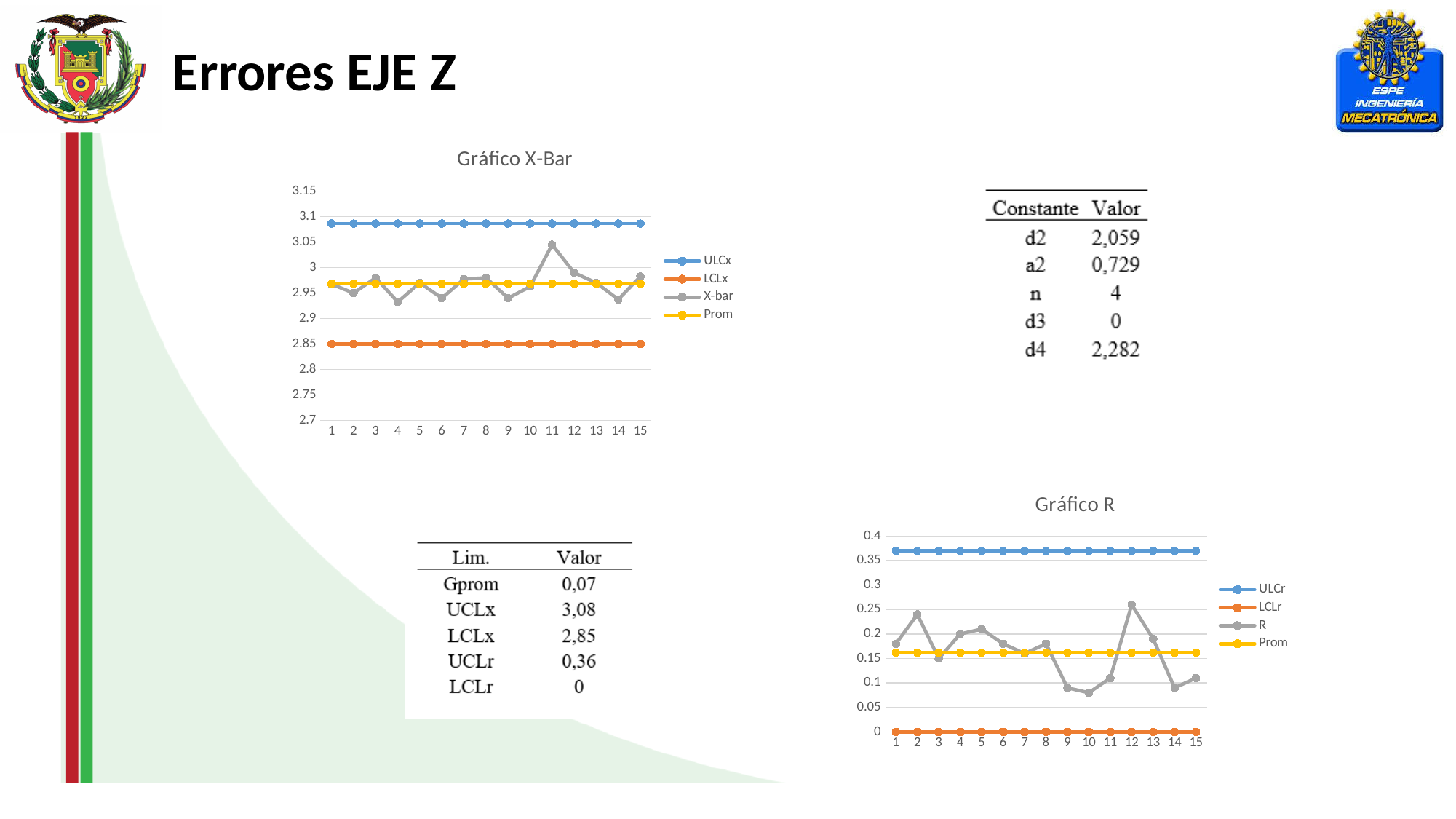
In the Gráfico R chart, is the R value at point 10 greater or less than 0.1? less How many points are plotted along the x axis of the Gráfico X-Bar chart? 15 What kind of chart is the Gráfico X-Bar chart? line chart In the Gráfico R chart, is the ULCr line greater or less than 0.35? greater In the Gráfico X-Bar chart, at which x-axis point does the X-bar series reach its highest value? 11 In the Gráfico X-Bar chart, is the X-bar value at point 11 greater or less than 3? greater In the Gráfico R chart, does the R series rise or fall from point 8 to point 10? fall How many series does the legend of the Gráfico R chart list? 4 In the Gráfico R chart, which is larger: the R value at point 2 or at point 3? point 2 Which series in the Gráfico X-Bar chart is drawn in yellow? Prom In the Gráfico R chart, what value does the LCLr line sit at? 0 In the Gráfico X-Bar chart, what value does the LCLx line sit at? 2.85